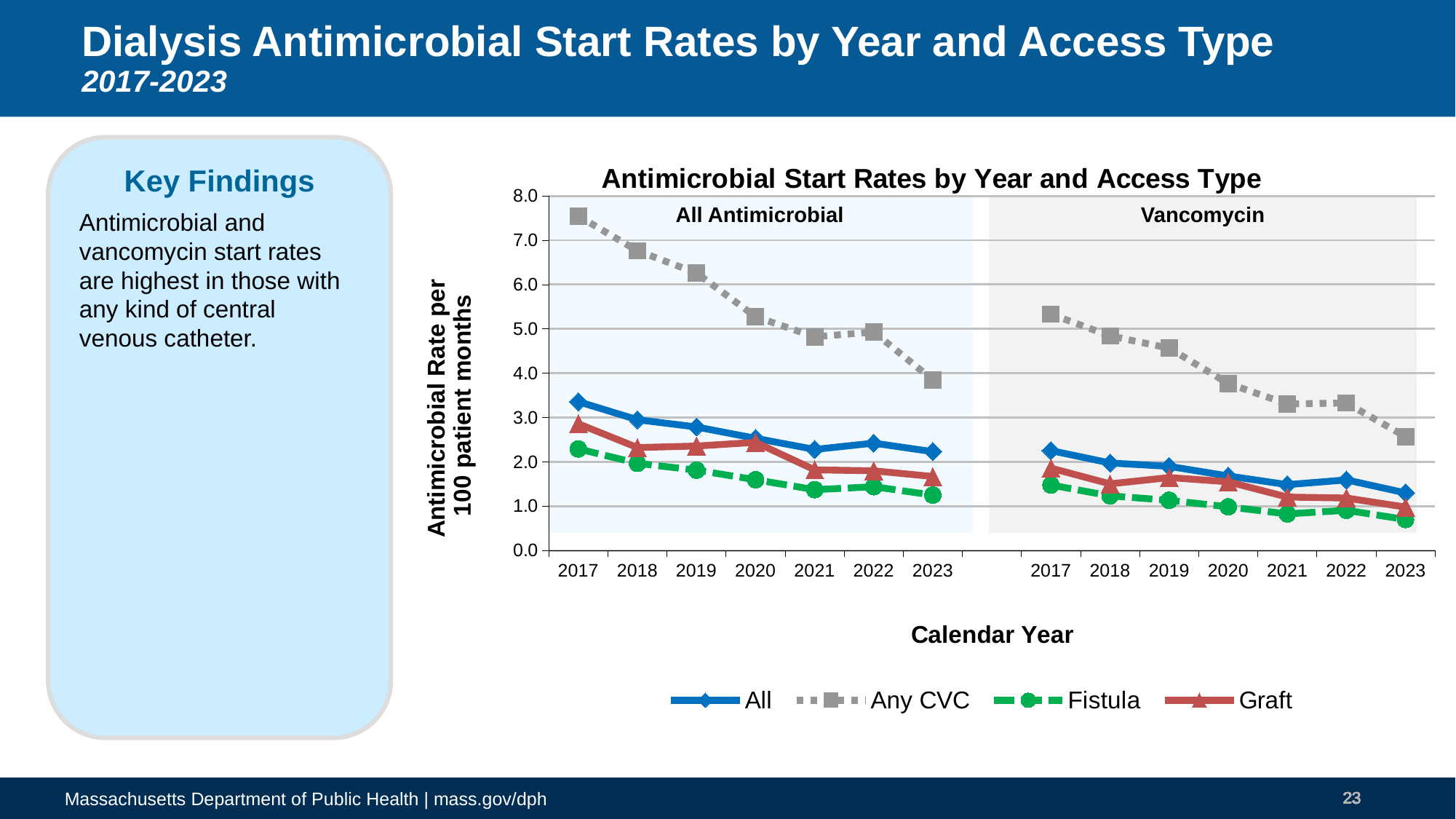
What is the label of the y axis? Antimicrobial Rate per 100 patient months In the All Antimicrobial panel, is the Any CVC value for 2023 greater or less than 4.0? less In the Vancomycin panel, is the Fistula value for 2023 greater or less than 1.0? less Does the Any CVC series in the All Antimicrobial panel rise or fall from 2017 to 2023? fall In the All Antimicrobial panel, which access type has the highest start rate in 2017? Any CVC In the All Antimicrobial panel, is the Any CVC value for 2017 greater or less than 7.0? greater How many years are plotted on the x axis within the All Antimicrobial panel? 7 How many series does the chart legend list? 4 In the All Antimicrobial panel, which access type has the lowest start rate in 2023? Fistula In the All Antimicrobial panel, which is larger in 2017: the Graft value or the Fistula value? Graft What kind of chart is shown on the slide? line chart